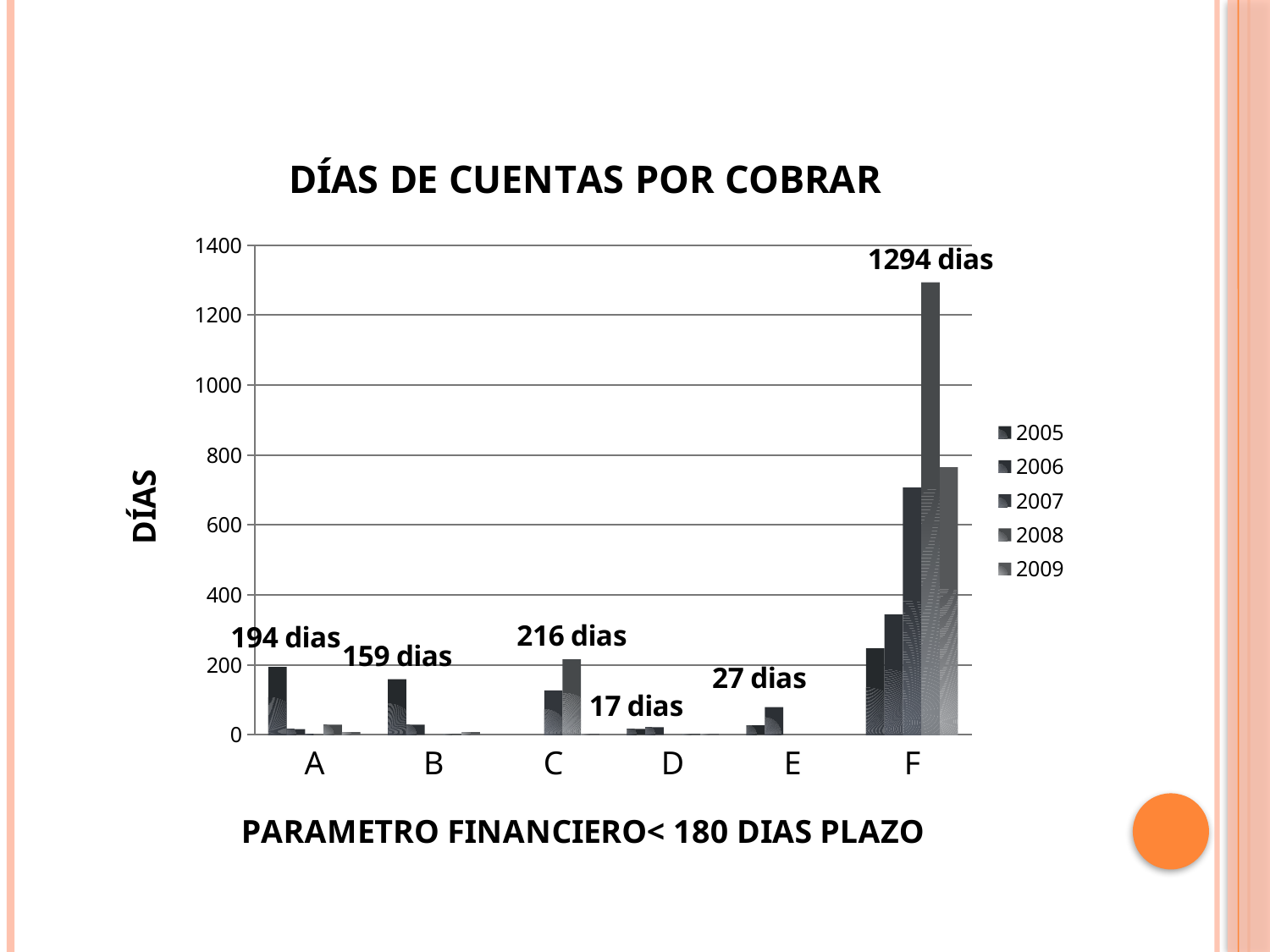
Is the 2007 value for category F greater or less than 600? greater How many series does the legend list? 5 What type of chart is shown on the slide? bar chart What value is labelled for category B? 159 dias What value is labelled for category A? 194 dias Which is larger, the labelled value for A or the labelled value for B? A What is the highest value labelled on the chart, for category F? 1294 dias How many categories are shown on the x axis? 6 Which category has the tallest bar in the chart? F What is the title of the chart? DÍAS DE CUENTAS POR COBRAR What value is labelled for category C? 216 dias What is the difference between the labelled value for F (1294 dias) and the labelled value for C (216 dias)? 1078 dias